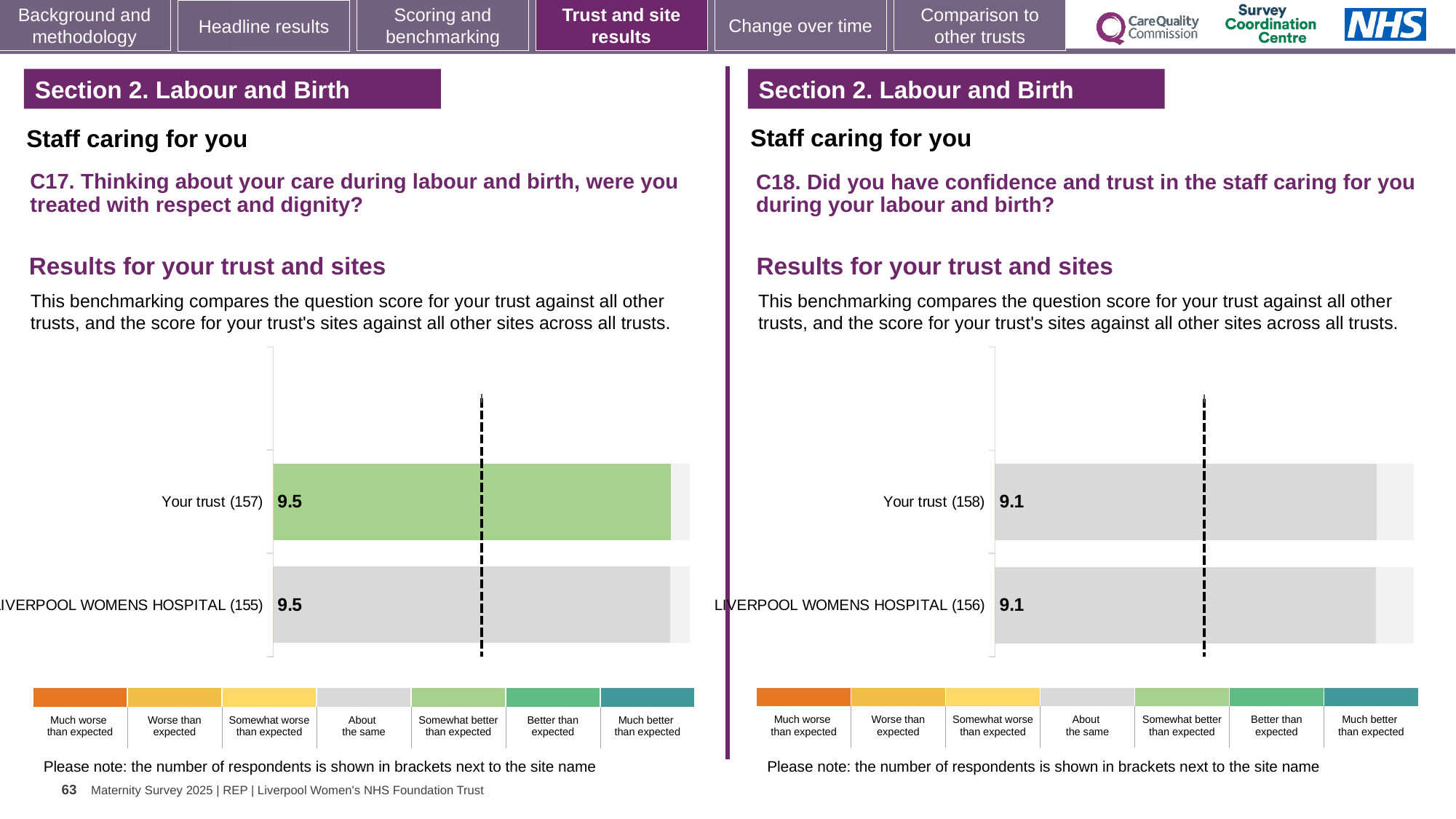
On the right chart (C18), what is the score for Your trust? 9.1 How many bars are plotted on the left chart (C17)? 2 On the left chart (C17), what is the difference between the Your trust score and the LIVERPOOL WOMENS HOSPITAL score? 0 On the left chart (C17), what is the score for Your trust? 9.5 On the right chart (C18), what is the score for LIVERPOOL WOMENS HOSPITAL? 9.1 On the right chart (C18), what is the difference between the Your trust score and the LIVERPOOL WOMENS HOSPITAL score? 0 How many bars are plotted on the right chart (C18)? 2 On the left chart (C17), how many respondents are shown in brackets for Your trust? 157 What kind of chart is used on the left (C17)? Bar chart On the left chart (C17), which benchmark category does the green colour of the Your trust bar correspond to in the legend? Somewhat better than expected On the left chart (C17), what is the score for LIVERPOOL WOMENS HOSPITAL? 9.5 On the right chart (C18), how many respondents are shown in brackets for LIVERPOOL WOMENS HOSPITAL? 156